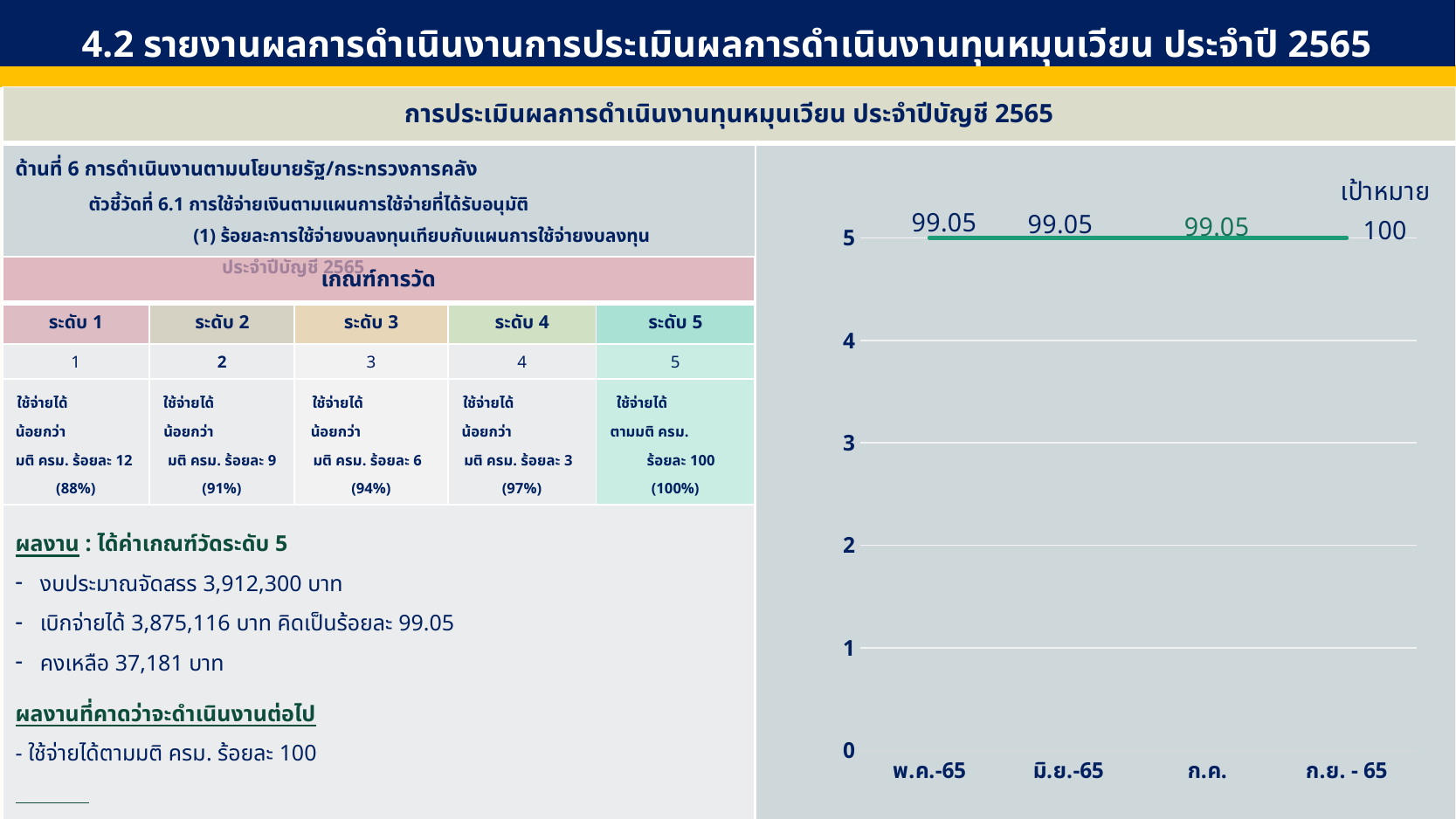
How many categories are shown on the x axis of the chart? 4 What word appears above the value 100 at the top right of the chart? เป้าหมาย Which has the larger labelled value on the chart, พ.ค.-65 or ก.ย. - 65? ก.ย. - 65 What value is labelled for พ.ค.-65 on the chart? 99.05 Which x-axis category has the highest labelled value on the chart? ก.ย. - 65 What is the highest tick value shown on the y axis of the chart? 5 What is the difference between the value labelled at ก.ย. - 65 (100) and the value labelled at พ.ค.-65 (99.05)? 0.95 What value is labelled at ก.ย. - 65, under the word เป้าหมาย, on the chart? 100 What kind of chart is shown on the right side of the slide? line chart What value is labelled for ก.ค. on the chart? 99.05 What is the first category label on the x axis of the chart? พ.ค.-65 What value is labelled for มิ.ย.-65 on the chart? 99.05